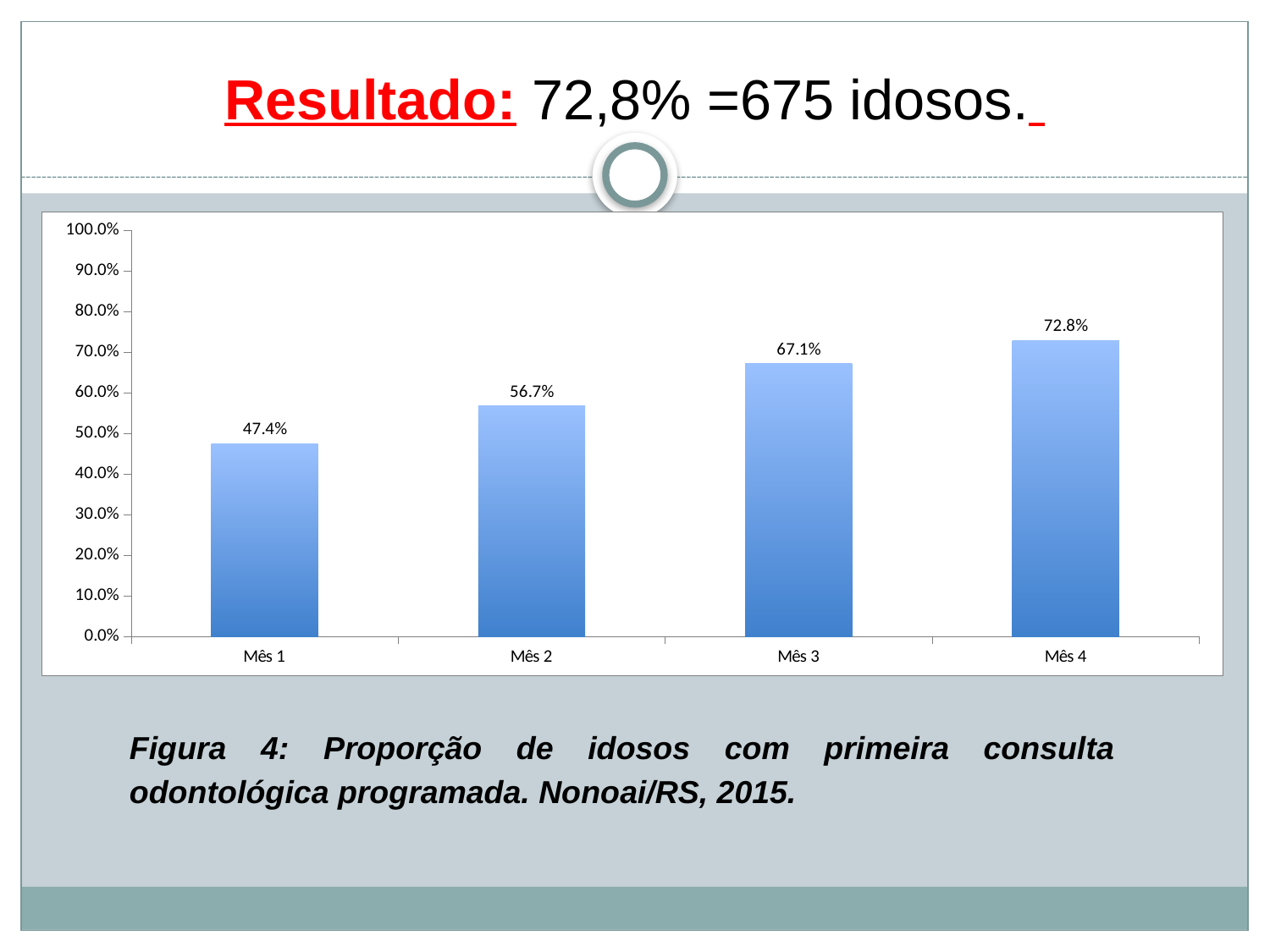
What kind of chart is shown on the slide? bar chart Do the values rise or fall from Mês 1 to Mês 4? rise What is the difference between the values for Mês 2 and Mês 1? 9.3% What is the value for Mês 4? 72.8% Which month has the highest value? Mês 4 What is the value for Mês 3? 67.1% Which is larger, the value for Mês 2 or the value for Mês 3? Mês 3 What is the difference between the values for Mês 4 and Mês 1? 25.4% Is the value for Mês 2 greater or less than 50.0%? greater What is the value for Mês 1? 47.4% How many months are shown on the x axis? 4 Which month has the lowest value? Mês 1